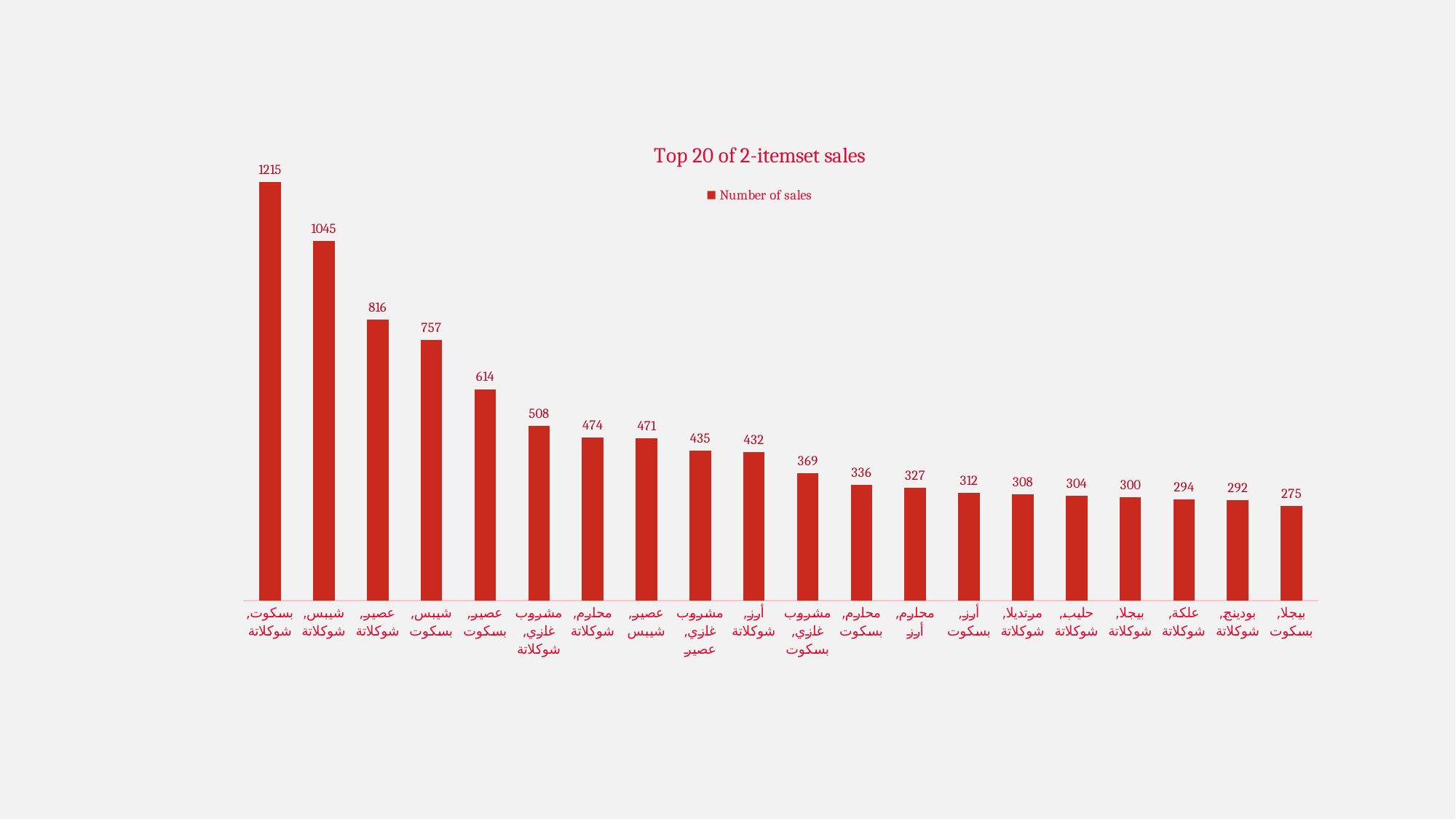
What is the number of sales for the itemset حليب, شوكلاتة? 304 Which itemset has more sales: عصير, شوكلاتة or عصير, بسكوت? عصير, شوكلاتة What kind of chart is shown on the slide? Bar chart Which itemset has the highest number of sales? بسكوت, شوكلاتة What is the difference in number of sales between بسكوت, شوكلاتة and شيبس, شوكلاتة? 170 How many series does the legend list? 1 What is the number of sales for the itemset بسكوت, شوكلاتة? 1215 Which itemset has the lowest number of sales? بيجلا, بسكوت What is the number of sales for the itemset شيبس, بسكوت? 757 Do the values rise or fall from left to right along the x axis? Fall How many itemsets are shown in the chart? 20 What is the number of sales for the itemset مشروب غازي, شوكلاتة? 508